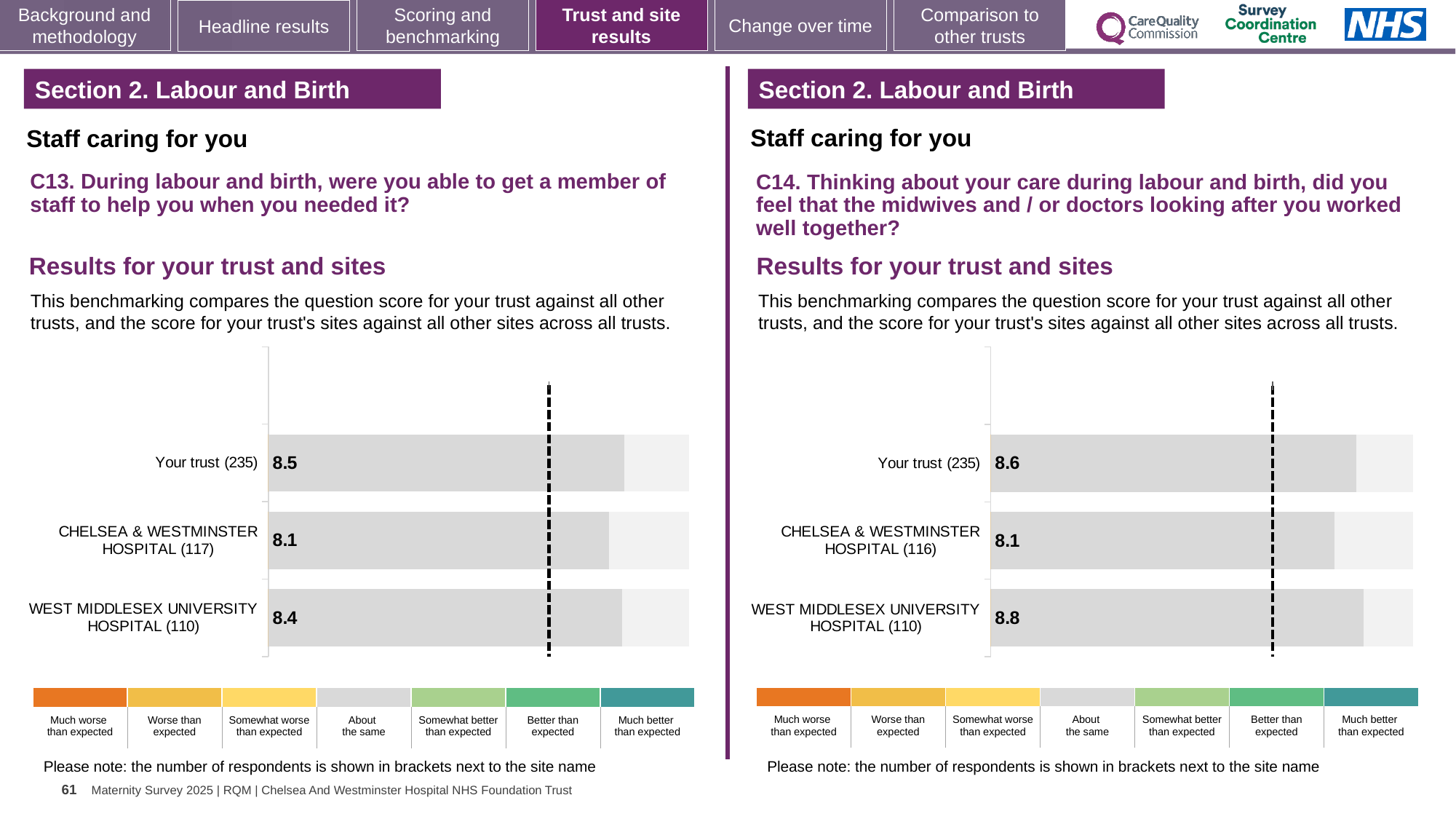
In the left chart (C13), which site or trust has the lowest score? CHELSEA & WESTMINSTER HOSPITAL (117) What kind of chart is used in the right chart (C14)? Bar chart In the right chart (C14), what is the difference between the score for WEST MIDDLESEX UNIVERSITY HOSPITAL (110) and the score for CHELSEA & WESTMINSTER HOSPITAL (116)? 0.7 In the left chart (C13), what is the difference between the score for Your trust (235) and the score for CHELSEA & WESTMINSTER HOSPITAL (117)? 0.4 In the left chart (C13), what is the score for WEST MIDDLESEX UNIVERSITY HOSPITAL (110)? 8.4 In the right chart (C14), what is the score for Your trust (235)? 8.6 In the right chart (C14), which has the larger score: Your trust (235) or CHELSEA & WESTMINSTER HOSPITAL (116)? Your trust (235) In the right chart (C14), which site or trust has the highest score? WEST MIDDLESEX UNIVERSITY HOSPITAL (110) In the right chart (C14), what is the score for WEST MIDDLESEX UNIVERSITY HOSPITAL (110)? 8.8 How many bars are plotted in the left chart (C13)? 3 In the left chart (C13), what is the score for CHELSEA & WESTMINSTER HOSPITAL (117)? 8.1 In the left chart (C13), what is the score for Your trust (235)? 8.5